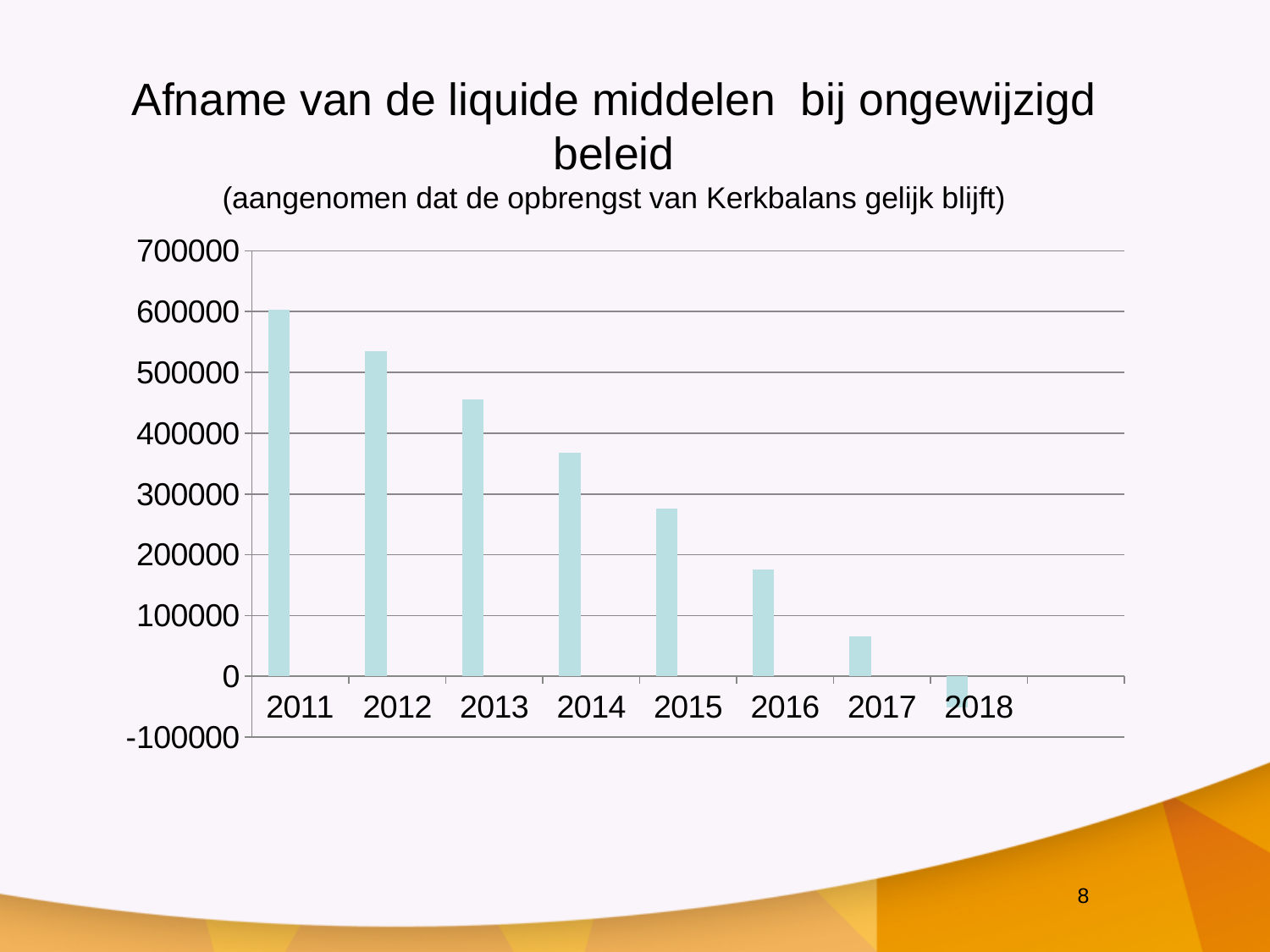
Do the values rise or fall from 2011 to 2018? fall How many years are shown on the x axis of the chart? 8 Which year has the lowest value in the chart? 2018 Is the value for 2014 greater or less than 400000? less Is the value for 2016 greater or less than 200000? less What kind of chart is shown on the slide? bar chart Is the value for 2012 greater or less than 500000? greater Which is larger, the value for 2013 or the value for 2015? 2013 What is the title of the chart on the slide? Afname van de liquide middelen bij ongewijzigd beleid Which year has the highest value in the chart? 2011